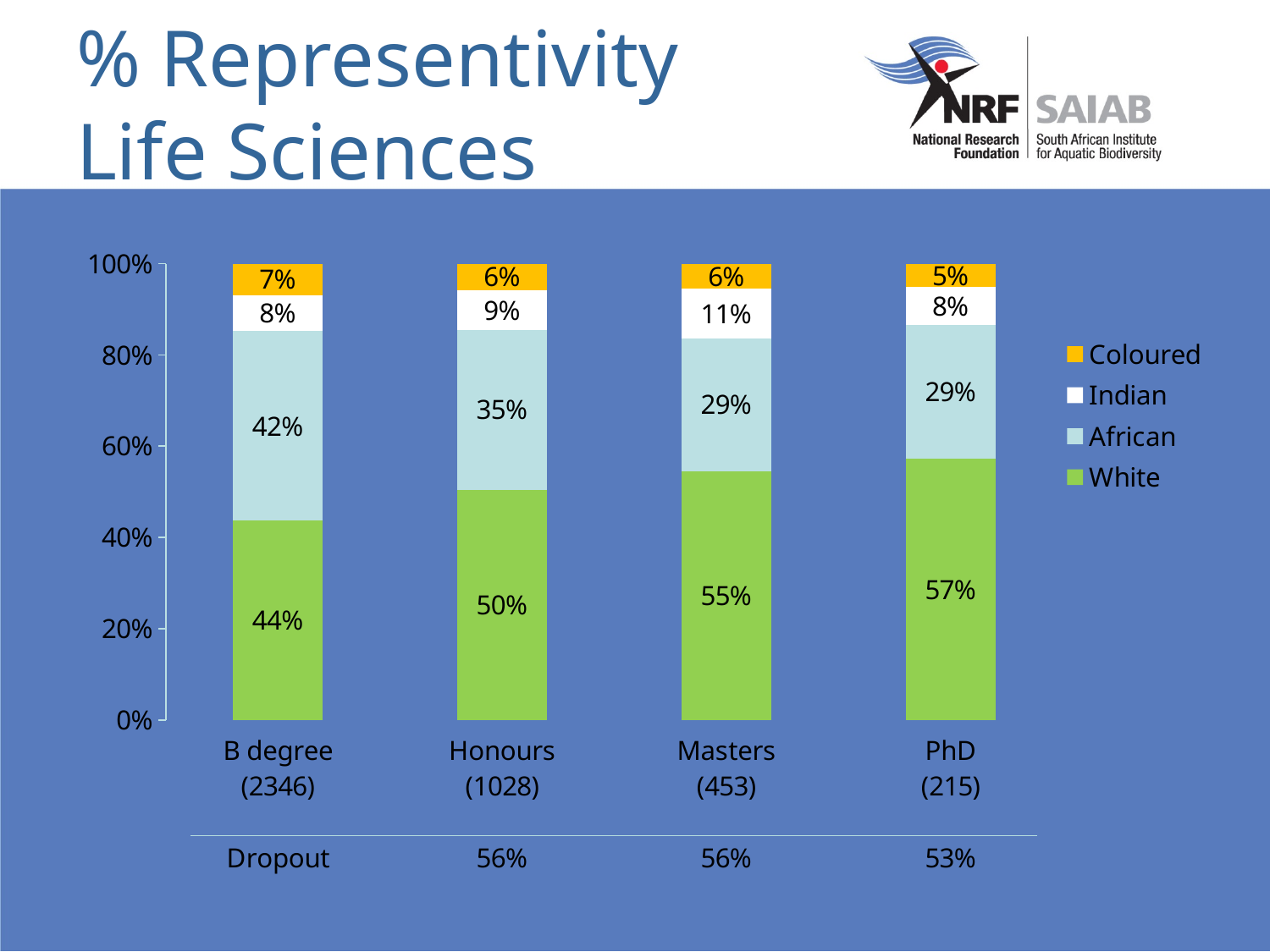
What is the African share for the B degree category? 42% Which category has the highest White share? PhD How many series does the legend list? 4 What is the Indian share for the Honours category? 9% What is the White share for the Masters category? 55% Which is larger, the Indian share for Masters or the Indian share for PhD? Masters Does the White share rise or fall from B degree to PhD? Rise Which category has the lowest African share? Masters and PhD (both 29%) How many categories are shown on the x axis? 4 What is the difference between the White share for PhD and the White share for B degree? 13% What is the Coloured share for the PhD category? 5% What kind of chart is shown on the slide? Stacked bar chart